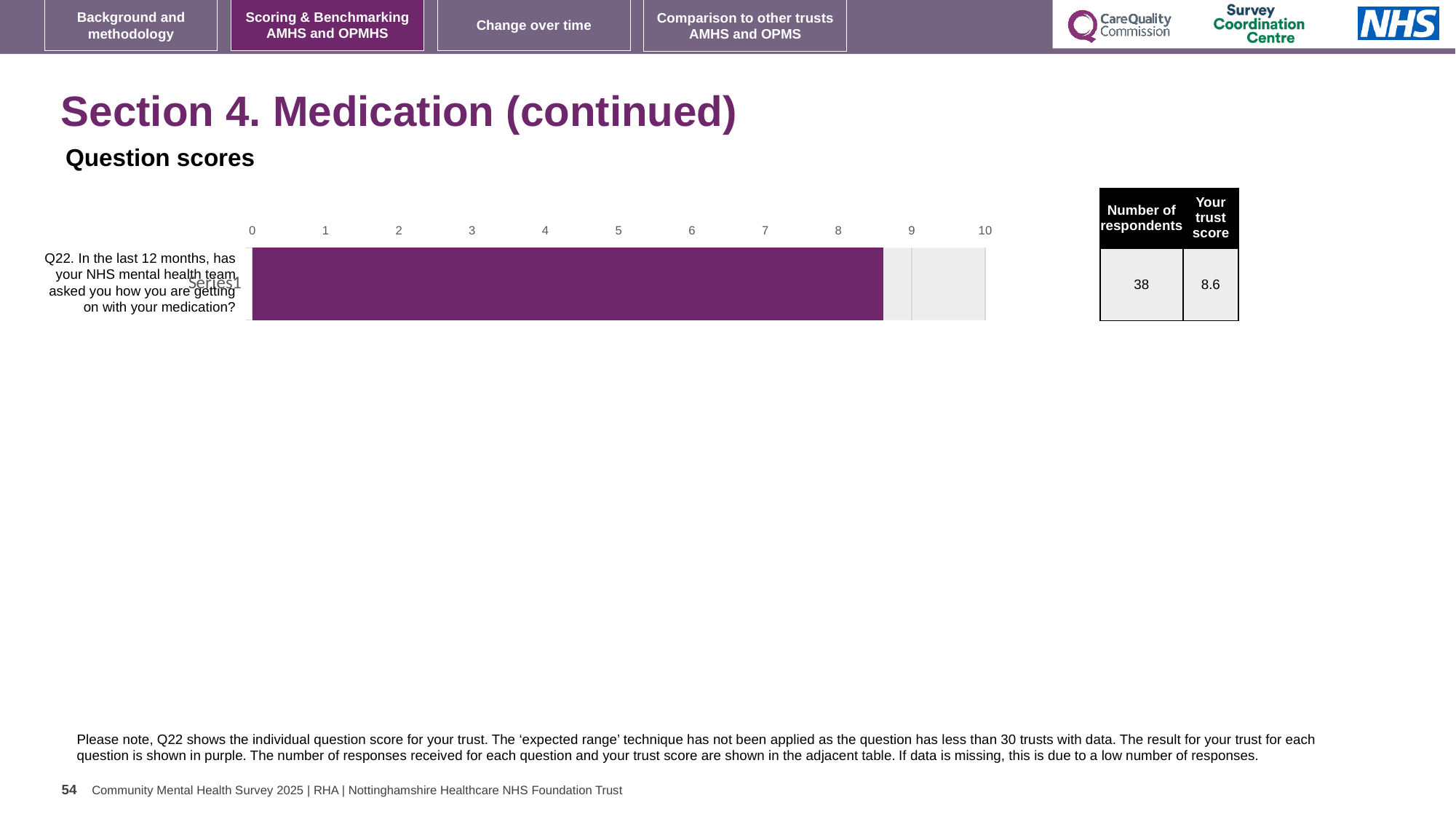
What is the maximum value shown on the chart's axis? 10 How many respondents are listed in the table for Q22? 38 Is the value of the bar for Q22 greater or less than 5? greater What kind of chart is shown on the slide? bar chart What is the trust score for Q22 shown on the slide? 8.6 How many questions (bars) are plotted in the chart? 1 Is the value of the bar for Q22 greater or less than 9? less Is the value of the bar for Q22 greater or less than 8? greater